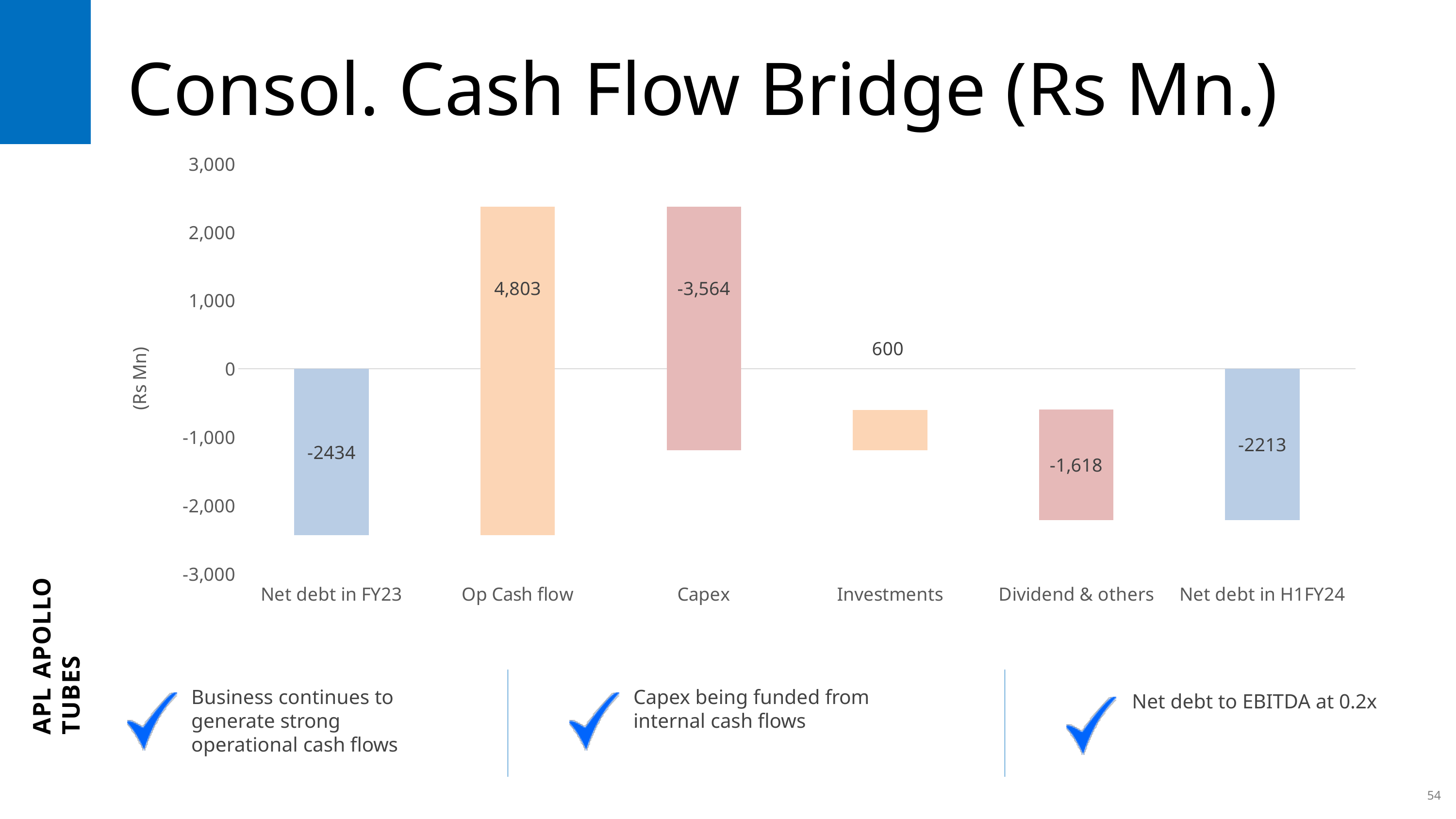
Which is larger, the value for Investments or the value for Dividend & others? Investments What is the value for Investments? 600 Which category has the highest value? Op Cash flow How many categories are shown on the x axis? 6 Which category has the lowest value? Capex What is the difference between the Net debt in FY23 value and the Net debt in H1FY24 value? 221 What is the value for Net debt in H1FY24? -2213 What is the title of the chart? Consol. Cash Flow Bridge (Rs Mn.) What is the value for Dividend & others? -1,618 What kind of chart is shown on the slide? Bar chart What is the value for Op Cash flow? 4,803 What is the value for Capex? -3,564